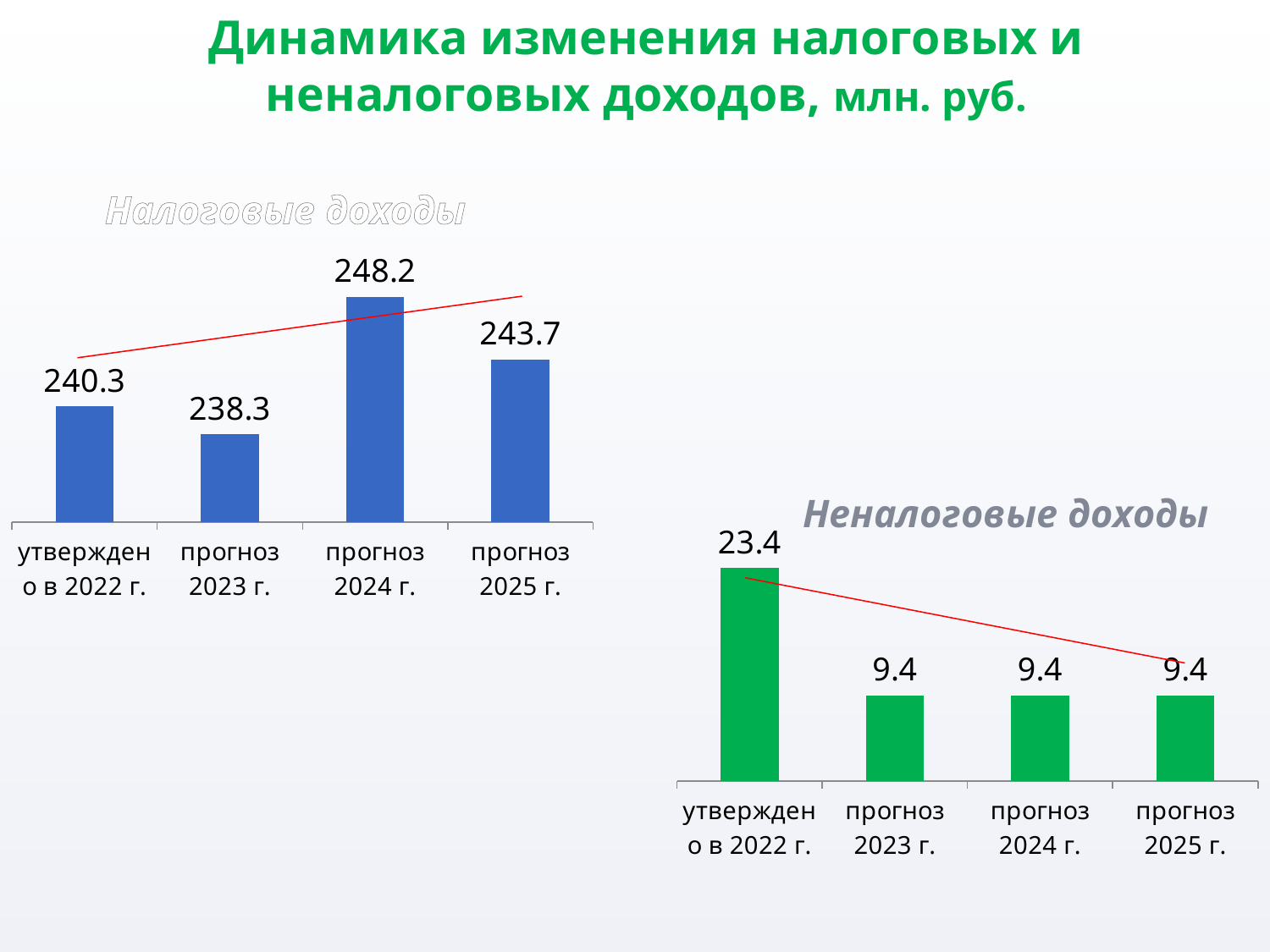
In the 'Налоговые доходы' chart, which is larger: the value for 'прогноз 2025 г.' or 'утверждено в 2022 г.'? прогноз 2025 г. In the 'Неналоговые доходы' chart, what is the value for 'прогноз 2025 г.'? 9.4 In the 'Налоговые доходы' chart, which category has the lowest value? прогноз 2023 г. In the 'Налоговые доходы' chart, what is the difference between the values for 'прогноз 2024 г.' and 'прогноз 2023 г.'? 9.9 What type of chart is the 'Налоговые доходы' chart? bar chart In the 'Налоговые доходы' chart, which category has the highest value? прогноз 2024 г. How many categories are shown in the 'Неналоговые доходы' chart? 4 In the 'Налоговые доходы' chart, what is the value for 'утверждено в 2022 г.'? 240.3 In the 'Неналоговые доходы' chart, what is the difference between the values for 'утверждено в 2022 г.' and 'прогноз 2023 г.'? 14.0 In the 'Неналоговые доходы' chart, which category has the highest value? утверждено в 2022 г. In the 'Налоговые доходы' chart, what is the value for 'прогноз 2024 г.'? 248.2 In the 'Неналоговые доходы' chart, what is the value for 'утверждено в 2022 г.'? 23.4